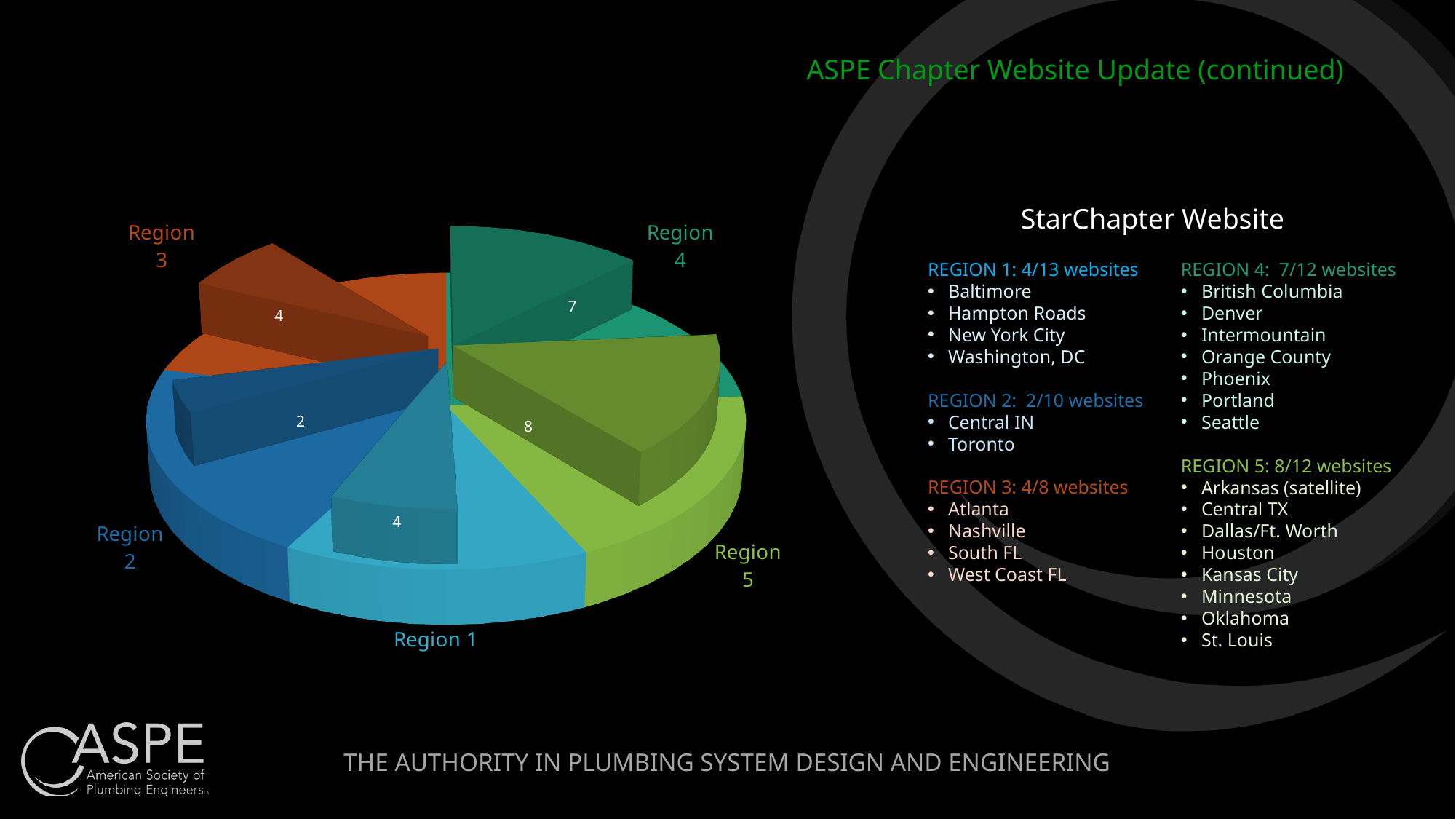
What is the difference between the values for Region 5 and Region 2 in the pie chart? 6 What is the value shown for Region 2 in the pie chart? 2 Which region has the smallest slice in the pie chart? Region 3 Which region has the largest slice in the pie chart? Region 1 What type of chart is shown on the slide? Pie chart What colour is the Region 3 slice in the pie chart? Orange/brown How many regions (slices) does the pie chart show? 5 What is the value shown for Region 4 in the pie chart? 7 What is the total of all the slice values in the pie chart? 25 What is the value shown for Region 5 in the pie chart? 8